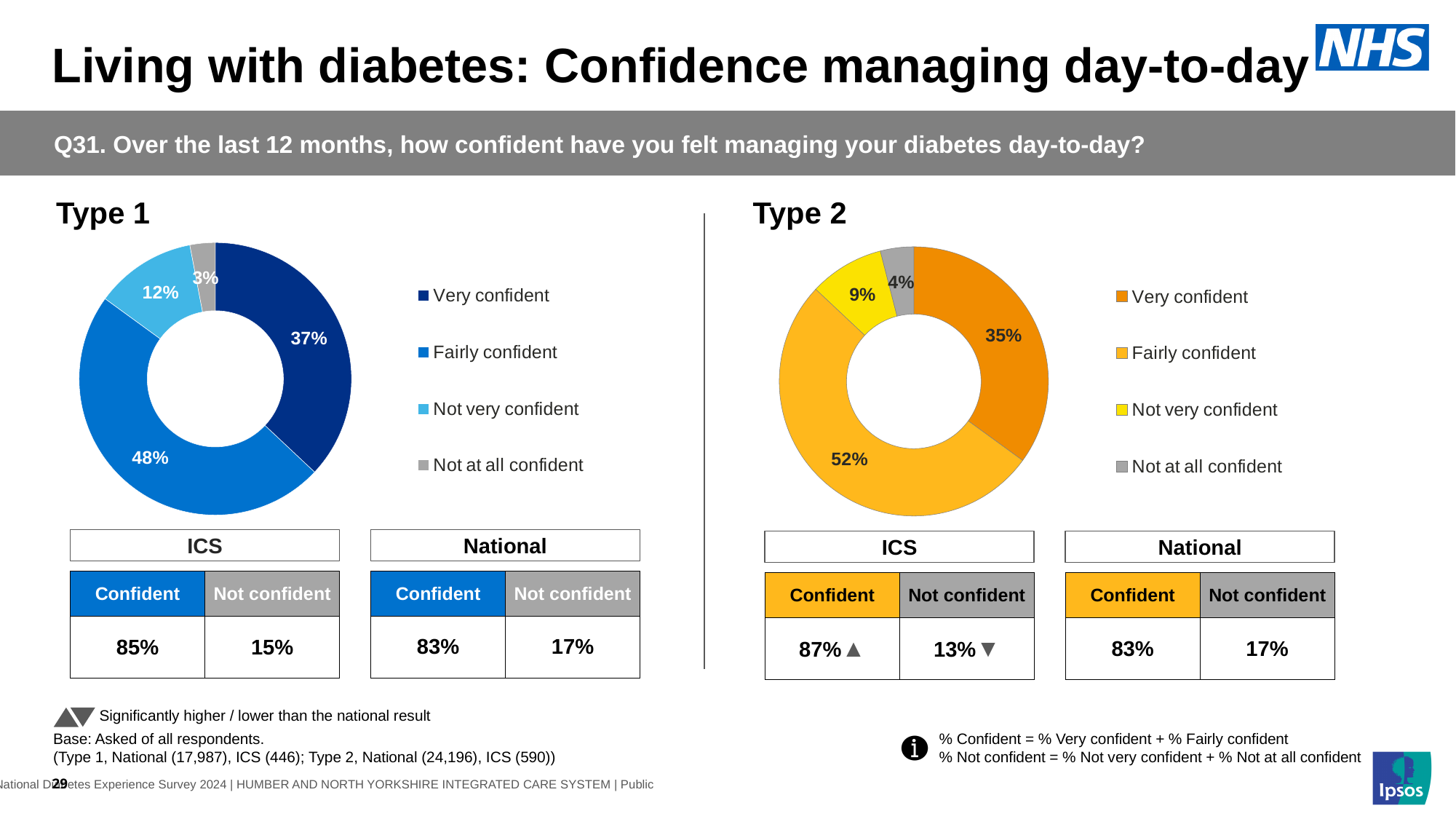
In the Type 2 chart, which category has the smallest share? Not at all confident In the Type 2 chart, what percentage of respondents were not at all confident? 4% How many categories does the Type 2 chart show? 4 In the Type 1 chart, what percentage of respondents were very confident? 37% In the Type 1 chart, what is the combined share of very confident and fairly confident? 85% In the Type 1 chart, which category has the largest share? Fairly confident In the Type 2 chart, which is larger: the not very confident share or the not at all confident share? Not very confident In the Type 1 chart, what is the difference between the fairly confident and very confident shares? 11 percentage points In the Type 2 chart, what percentage of respondents were fairly confident? 52% What kind of chart is used for Type 1? Doughnut chart In the Type 2 chart, what colour is the fairly confident segment? Yellow-orange In the Type 1 chart, what percentage of respondents were not very confident? 12%